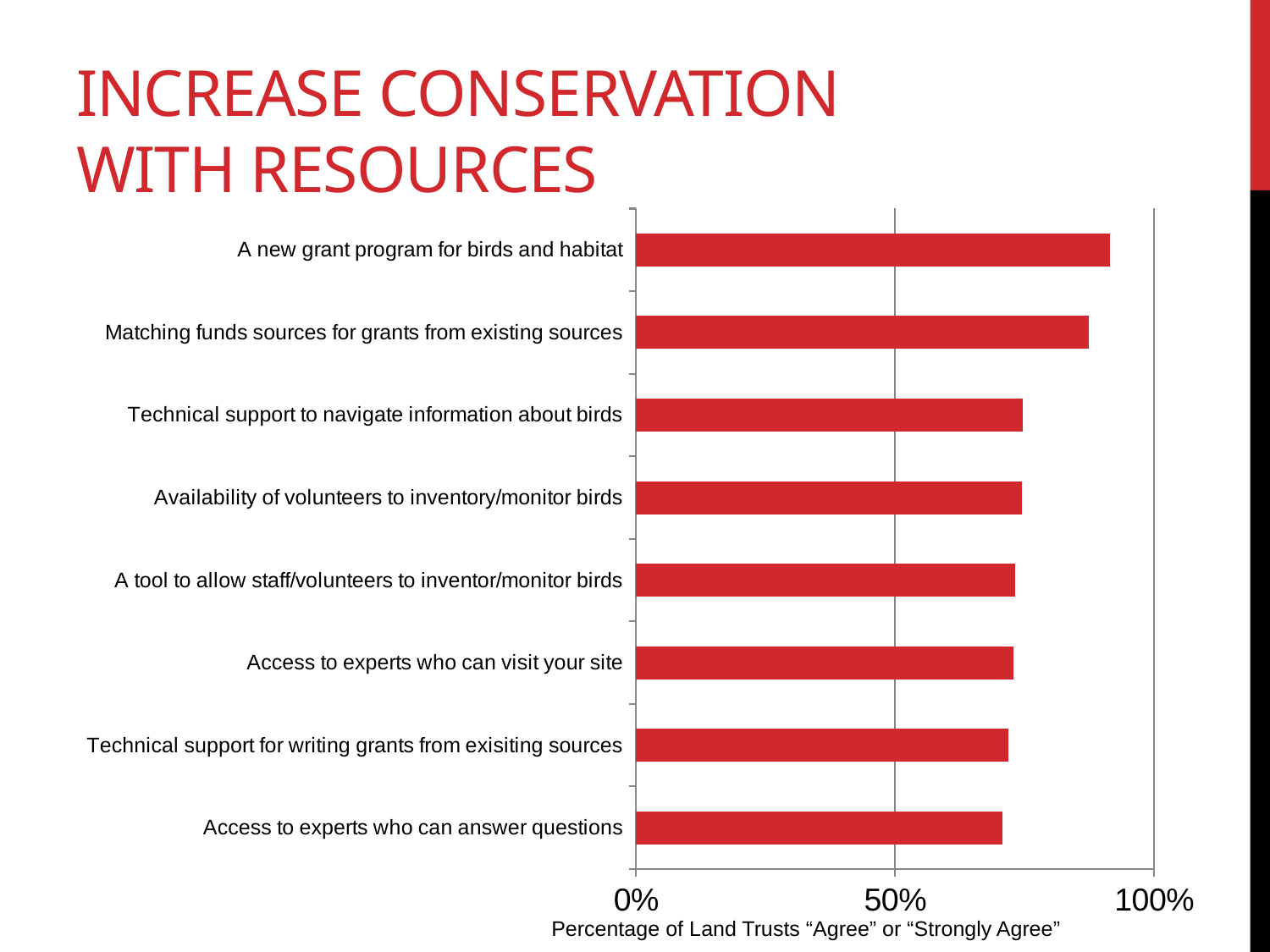
How many categories (resources) are plotted in the chart? 8 Is the value for "A new grant program for birds and habitat" greater or less than 100%? less Is the value for "Technical support for writing grants from exisiting sources" greater or less than 50%? greater What is the title of the slide containing the chart? INCREASE CONSERVATION WITH RESOURCES Which has a larger value: "A new grant program for birds and habitat" or "Technical support to navigate information about birds"? A new grant program for birds and habitat Which resource has the highest percentage of land trusts that agree or strongly agree? A new grant program for birds and habitat Is the value for "Access to experts who can answer questions" greater or less than 50%? greater Which has a larger value: "Matching funds sources for grants from existing sources" or "Access to experts who can answer questions"? Matching funds sources for grants from existing sources Which has a larger value: "Access to experts who can visit your site" or "A new grant program for birds and habitat"? A new grant program for birds and habitat What kind of chart is shown on the slide? bar chart What is the label on the horizontal axis of the chart? Percentage of Land Trusts "Agree" or "Strongly Agree"